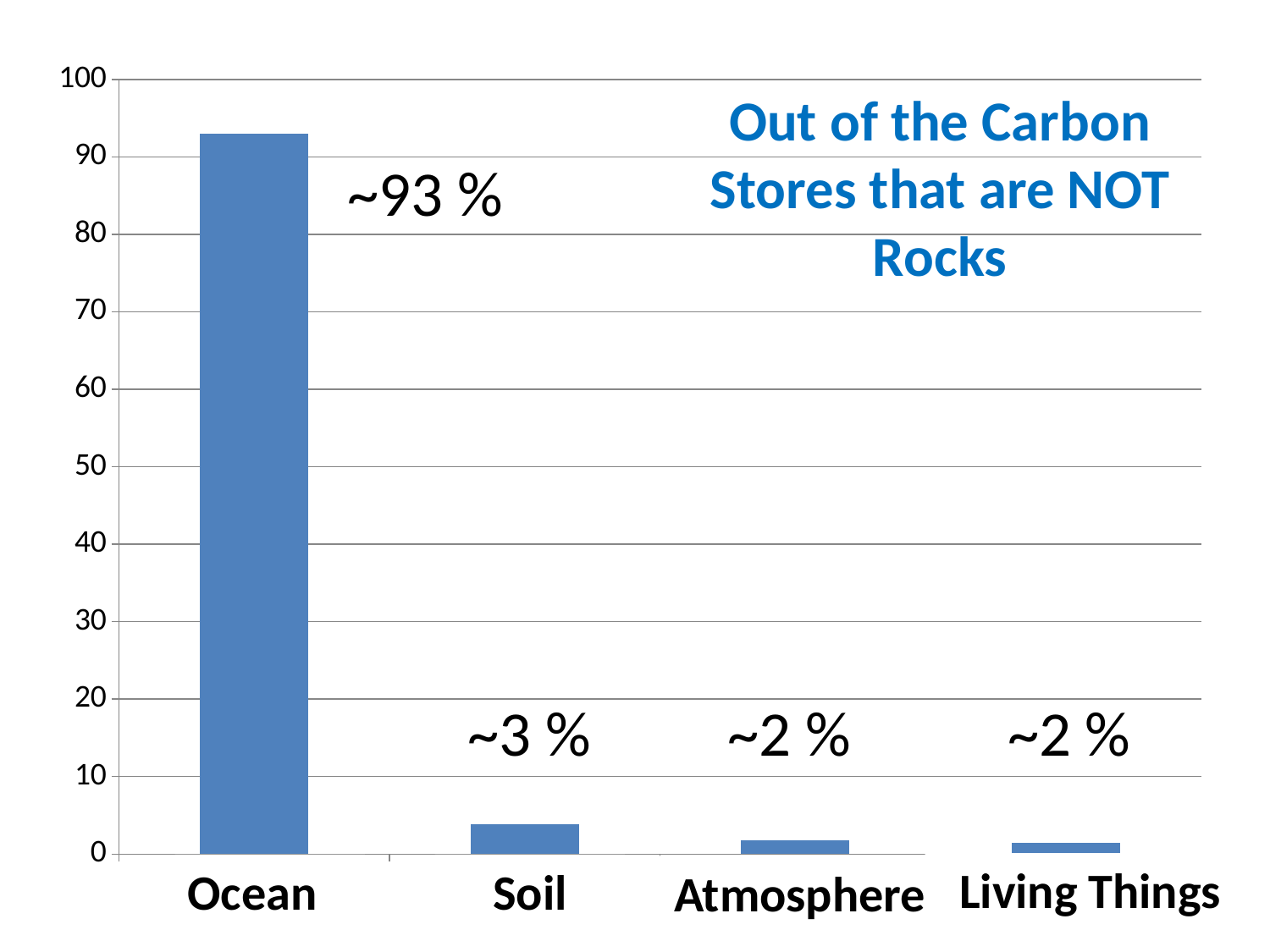
What is the highest value shown on the y axis of the chart? 100 Do the values rise or fall moving from Ocean to Living Things along the x axis? fall Which is larger, the value for Soil or the value for Living Things? Soil Is the value for Soil greater or less than 10? less Which category has the highest value in the chart? Ocean What kind of chart is shown on the slide? bar chart Which is larger, the value for Ocean or the value for Soil? Ocean What is the title text shown on the chart? Out of the Carbon Stores that are NOT Rocks Is the value for Atmosphere greater or less than 10? less How many categories are shown on the x axis of the chart? 4 Is the value for Living Things greater or less than 10? less